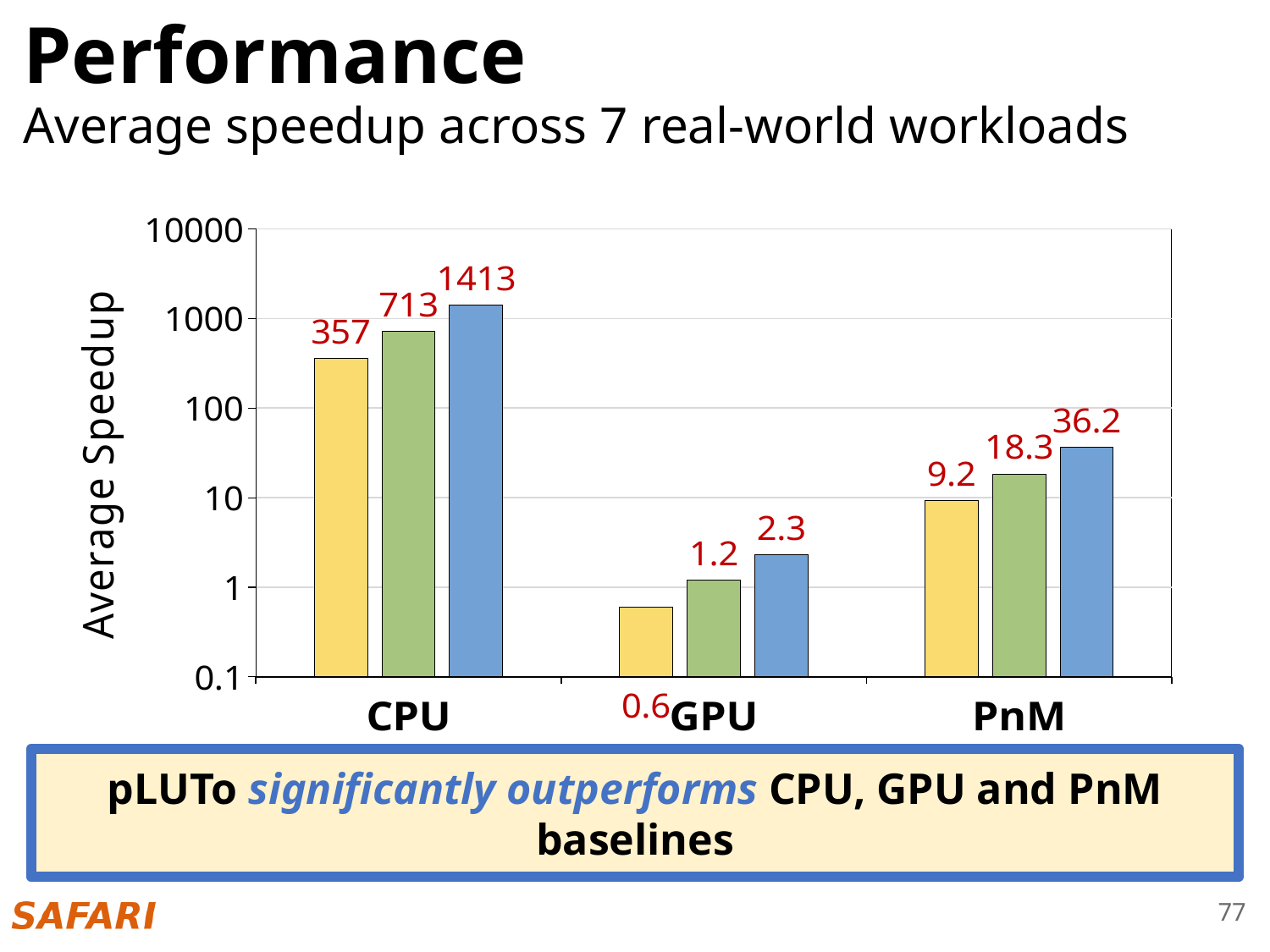
How many categories are shown on the x axis? 3 What kind of chart is shown on the slide? Bar chart What is the difference between the blue bar and the green bar for PnM? 17.9 Which category has the highest blue bar? CPU Which category has the lowest yellow bar? GPU What is the value of the yellow bar for GPU? 0.6 What is the label of the y axis? Average Speedup Is the value of the yellow bar for GPU greater or less than 1? less What is the value of the blue bar for CPU? 1413 Which is larger: the green bar for PnM or the blue bar for GPU? The green bar for PnM What is the value of the green bar for PnM? 18.3 What is the difference between the blue bar and the yellow bar for CPU? 1056